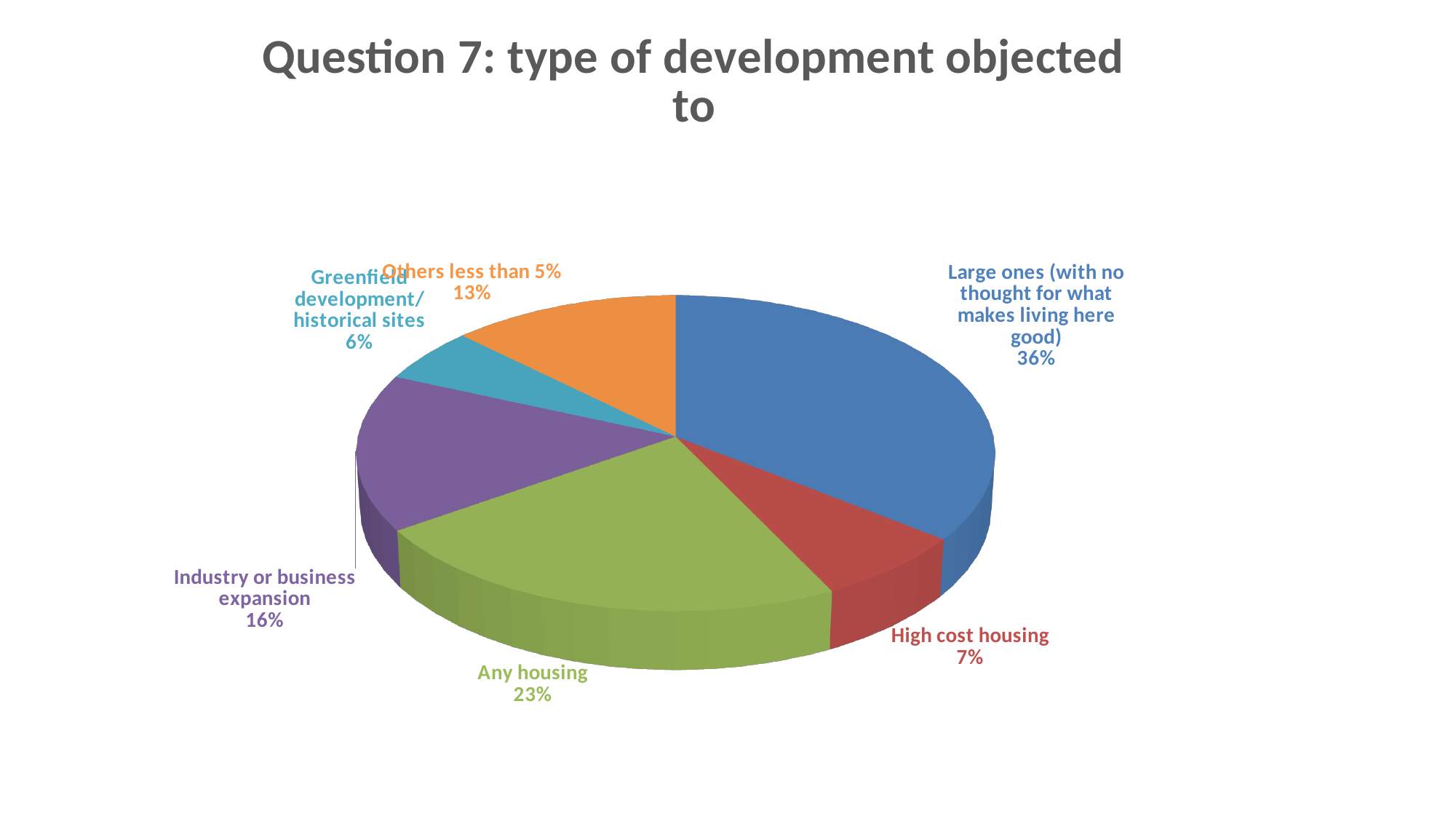
What kind of chart is shown on the slide? Pie chart What is the title of the chart? Question 7: type of development objected to Which is larger, the share for 'Others less than 5%' or the share for 'High cost housing'? Others less than 5% What share of the pie is 'Industry or business expansion'? 16% How many categories are shown in the pie chart? 6 What share of the pie is 'Others less than 5%'? 13% What share of the pie is 'Greenfield development/ historical sites'? 6% Which category has the largest share of the pie? Large ones (with no thought for what makes living here good) What is the difference in percentage points between 'Any housing' and 'Industry or business expansion'? 7 What share of the pie is 'Any housing'? 23% What share of the pie is 'High cost housing'? 7% Which category has the smallest share of the pie? Greenfield development/ historical sites